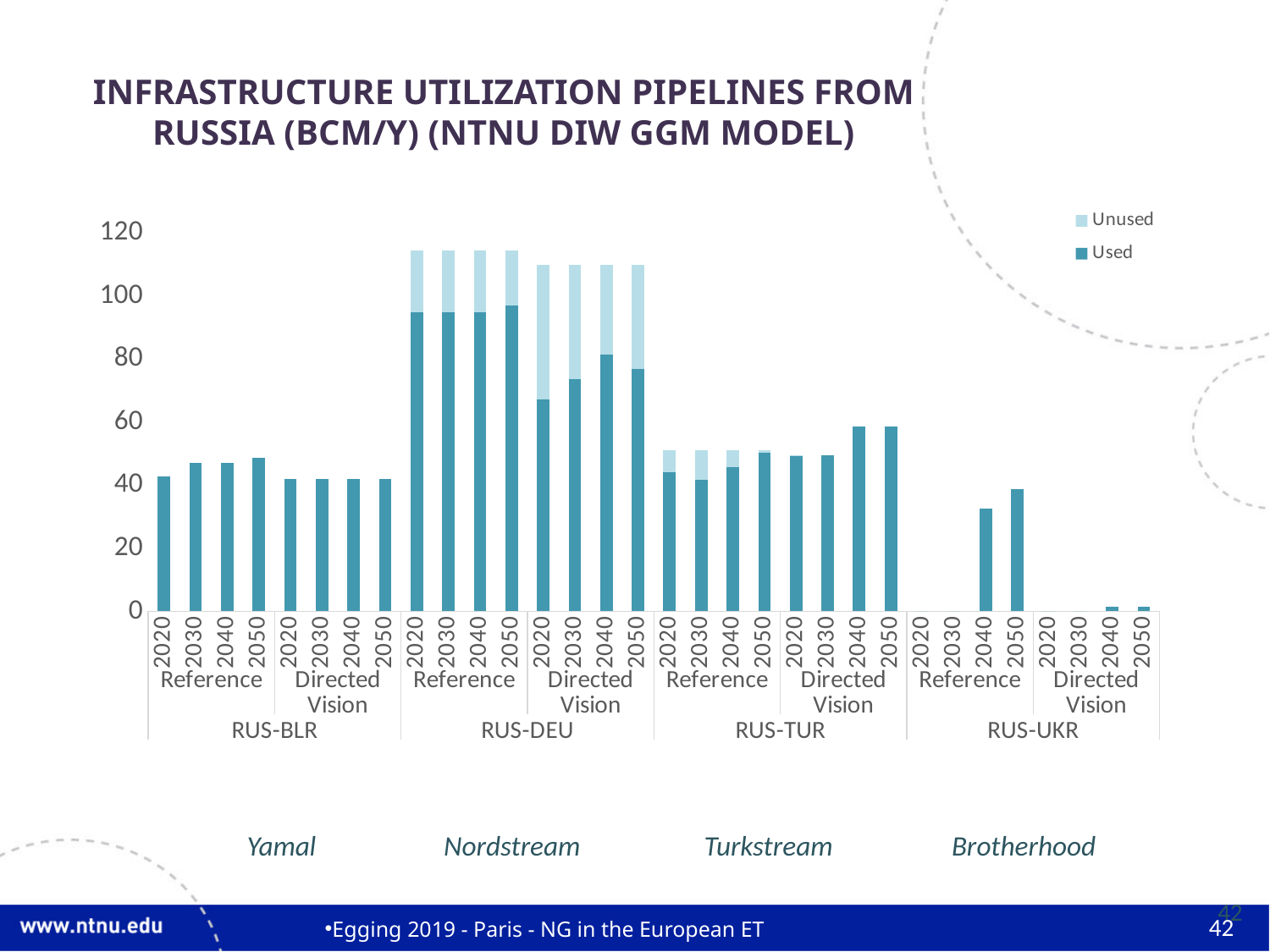
Is the value for RUS-UKR Reference 2040 greater or less than 40? less Is the value for RUS-BLR Reference 2020 greater or less than 60? less Which pipeline route has the tallest bars overall? RUS-DEU How many years are plotted for each scenario within a pipeline route? 4 What are the two series named in the legend? Unused and Used How many pipeline routes (RUS-BLR, RUS-DEU, etc.) are shown along the x axis? 4 Is the total bar for RUS-DEU Reference 2020 greater or less than 100? greater Which is larger, the total bar for RUS-DEU Reference 2020 or for RUS-TUR Reference 2020? RUS-DEU Reference 2020 Which pipeline route has the lowest bars overall? RUS-UKR How many series does the legend list? 2 What kind of chart is shown on the slide? Stacked bar chart Do the bars for RUS-TUR Directed Vision rise or fall from 2020 to 2050? rise